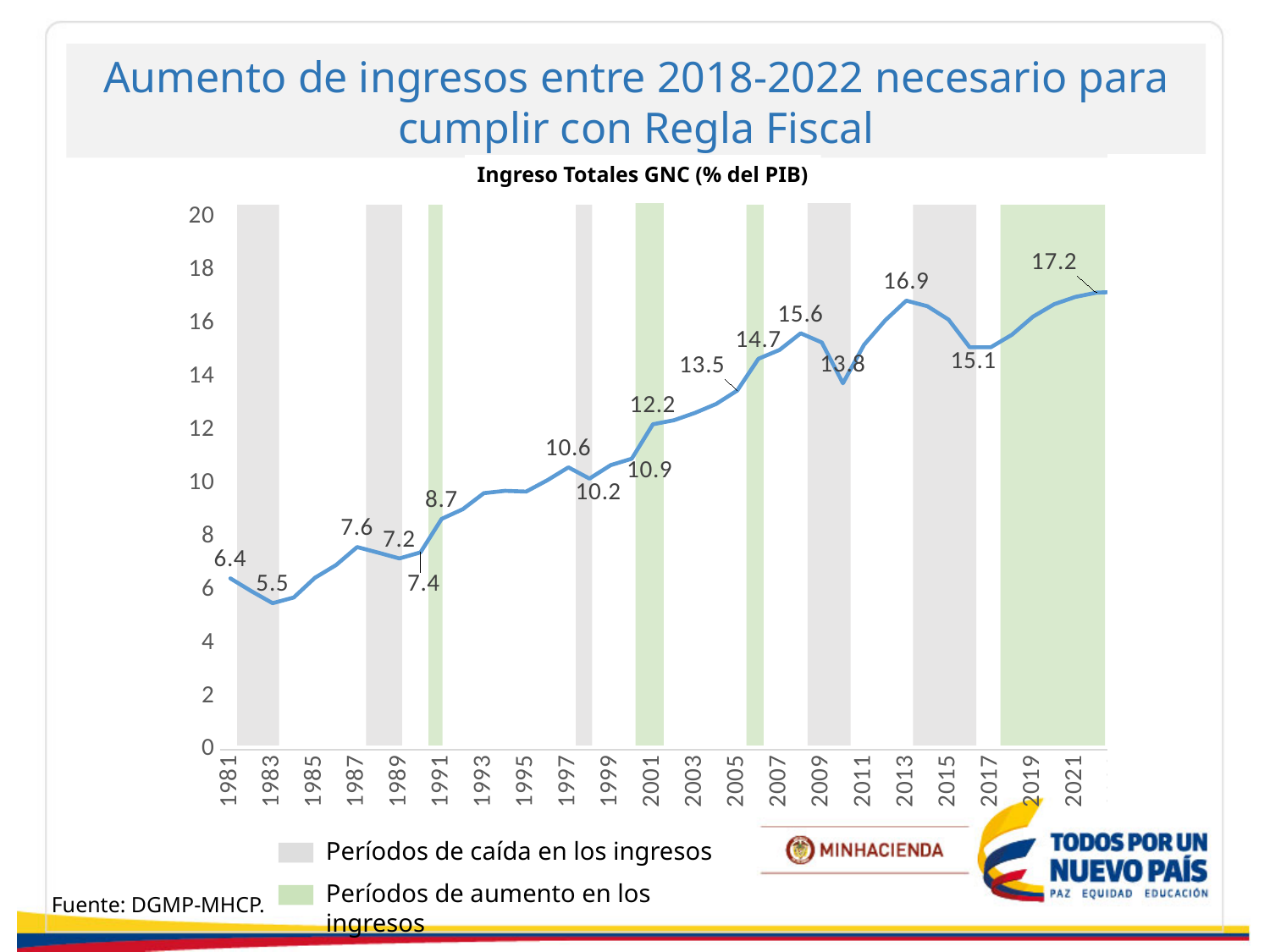
What is the highest value labelled on the line? 17.2 What is the lowest value labelled on the line? 5.5 What is the title of the chart? Ingreso Totales GNC (% del PIB) What kind of chart is shown on the slide? line chart What is the difference between the labelled values 17.2 and 15.1? 2.1 What is the value labelled for 1983? 5.5 Overall, do the values rise or fall from 1981 to 2022? rise How many entries does the legend below the chart list? 2 What is the value labelled for 2017? 15.1 What is the value labelled for 2013? 16.9 What is the value labelled for 1981? 6.4 Which is larger, the labelled value for 1987 or for 1989? 1987